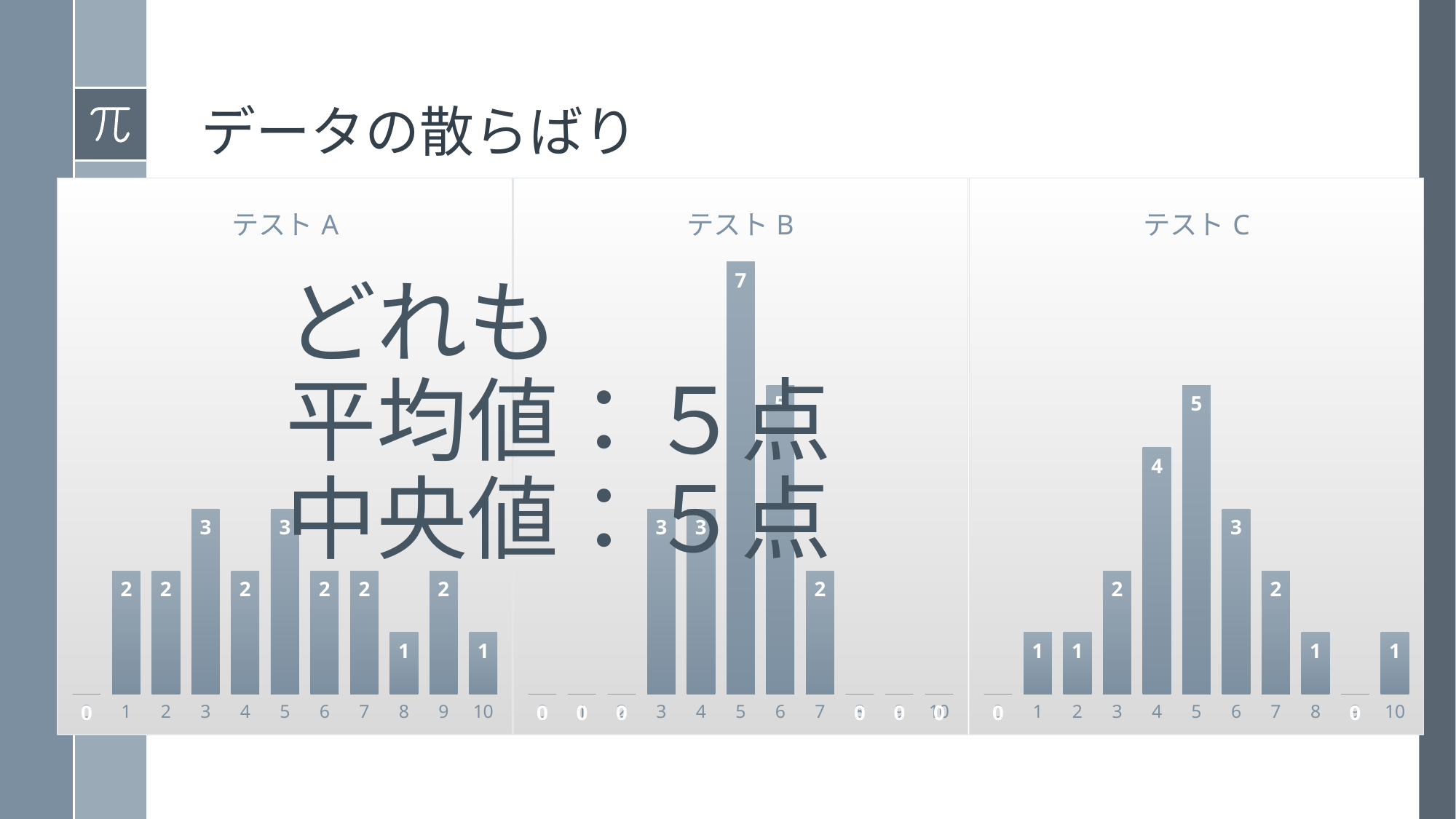
In the テスト B chart, what is the value for category 7? 2 In the テスト C chart, what is the difference between the values for category 5 and category 6? 2 In the テスト B chart, which is larger, the value for category 5 or the value for category 3? category 5 In the テスト C chart, what is the value for category 4? 4 In the テスト C chart, what is the value for category 9? 0 What kind of chart is the テスト A chart? bar chart In the テスト A chart, what is the value for category 8? 1 How many charts are shown on the slide? 3 In the テスト B chart, which category has the highest value? 5 In the テスト C chart, which category has the highest value? 5 In the テスト A chart, what is the value for category 3? 3 In the テスト B chart, what is the value for category 5? 7